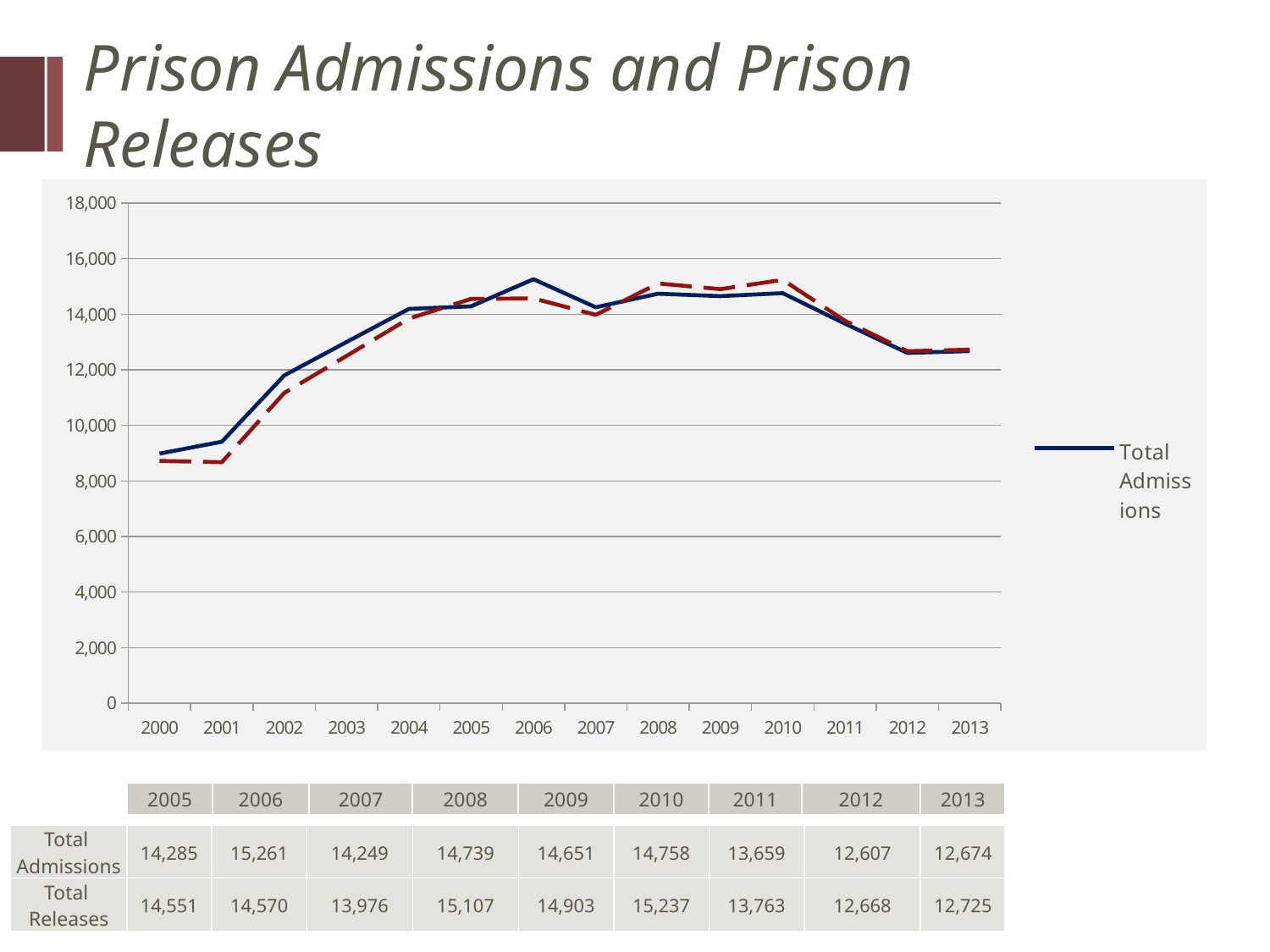
What kind of chart is shown on the slide? line chart Among the years 2005 to 2013 listed in the table, which year had the lowest Total Admissions? 2012 What was the value of Total Admissions in 2006? 15,261 Among the years 2005 to 2013 listed in the table, which year had the highest Total Admissions? 2006 What is the title of the slide? Prison Admissions and Prison Releases How many years are shown on the x axis of the chart? 14 In 2009, which was larger: Total Admissions or Total Releases? Total Releases What was the value of Total Releases in 2010? 15,237 Is the value for Total Admissions in 2004 greater or less than 12,000? greater Is the value for Total Admissions in 2000 greater or less than 10,000? less Between 2010 and 2012, did Total Admissions rise or fall? fall In 2008, how much greater were Total Releases than Total Admissions? 368